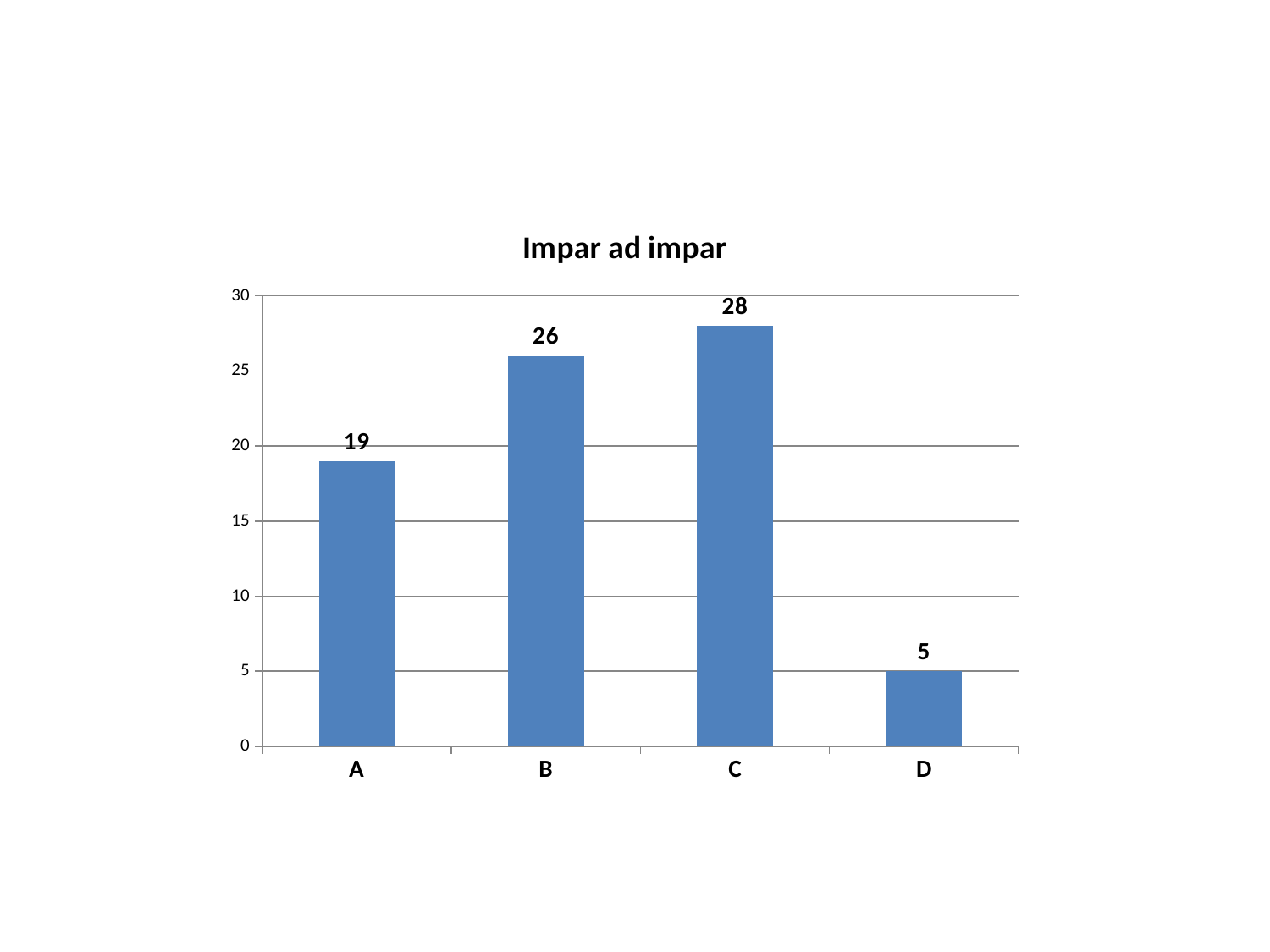
What is the difference between the values for B and D? 21 Which category has the lowest value? D What is the title of the chart? Impar ad impar Is the value for D greater or less than 10? less What is the difference between the values for C and A? 9 What is the value for category C? 28 What is the value for category D? 5 Which category has the highest value? C How many categories are shown on the x axis? 4 Which is larger, the value for A or the value for B? B What is the value for category A? 19 What is the value for category B? 26